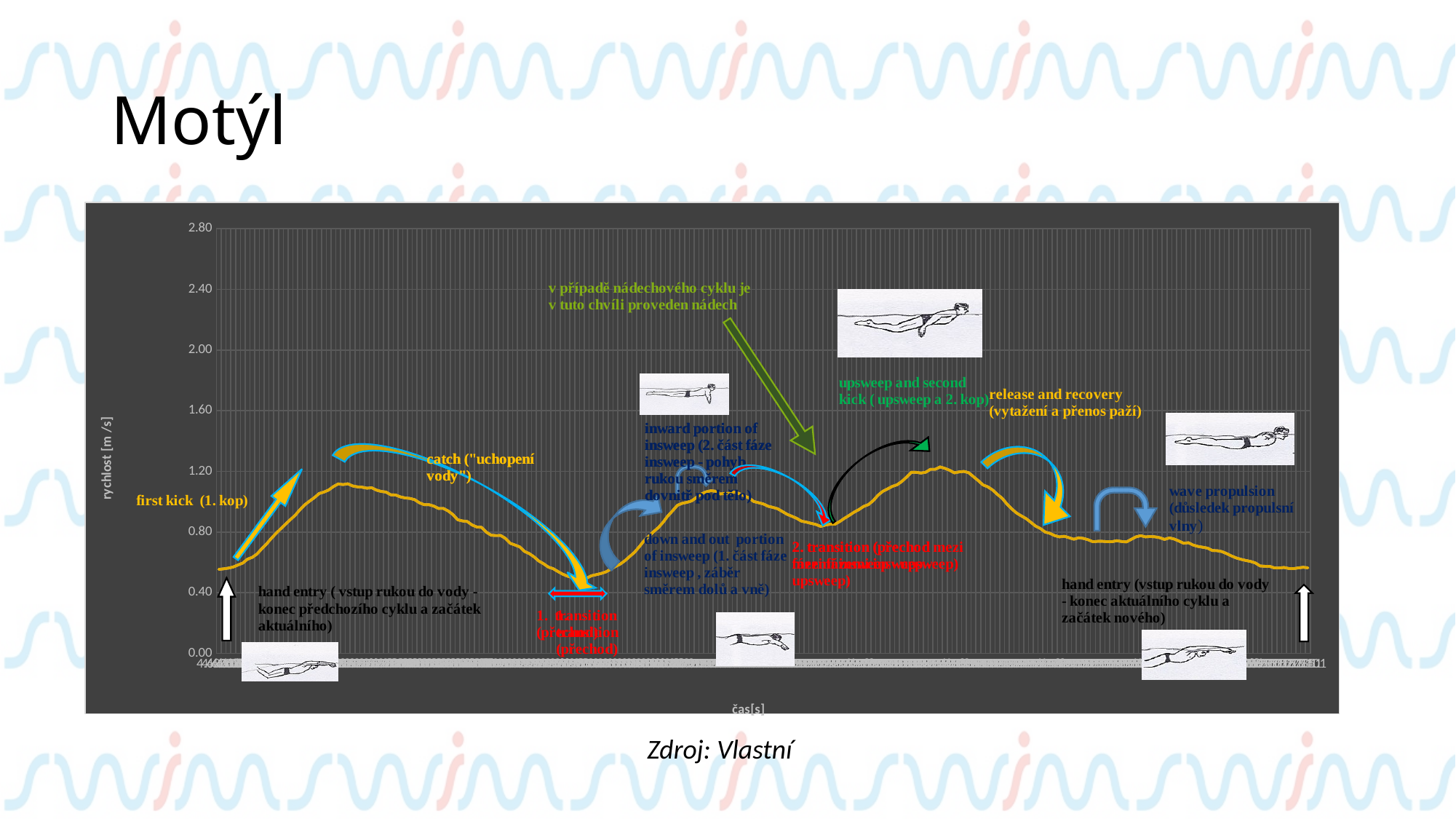
Does the speed rise or fall between the first "hand entry" and the "catch" peak? rise What is the label of the vertical axis of the chart? rychlost [m /s] Is the speed at the peak labelled "catch ("uchopení vody")" greater or less than 0.80? greater What is the label of the horizontal axis of the chart? čas[s] Is the speed at the start of the curve, at the first "hand entry", greater or less than 0.80? less Is the speed at the "catch" peak higher or lower than at the "1. transition" trough? higher Which labelled point on the curve has the lowest speed? 1. transition (přechod) What kind of chart is shown on the slide? line chart Is the speed at the point labelled "1. transition (přechod)" greater or less than 0.80? less What is the highest tick value shown on the vertical axis? 2.80